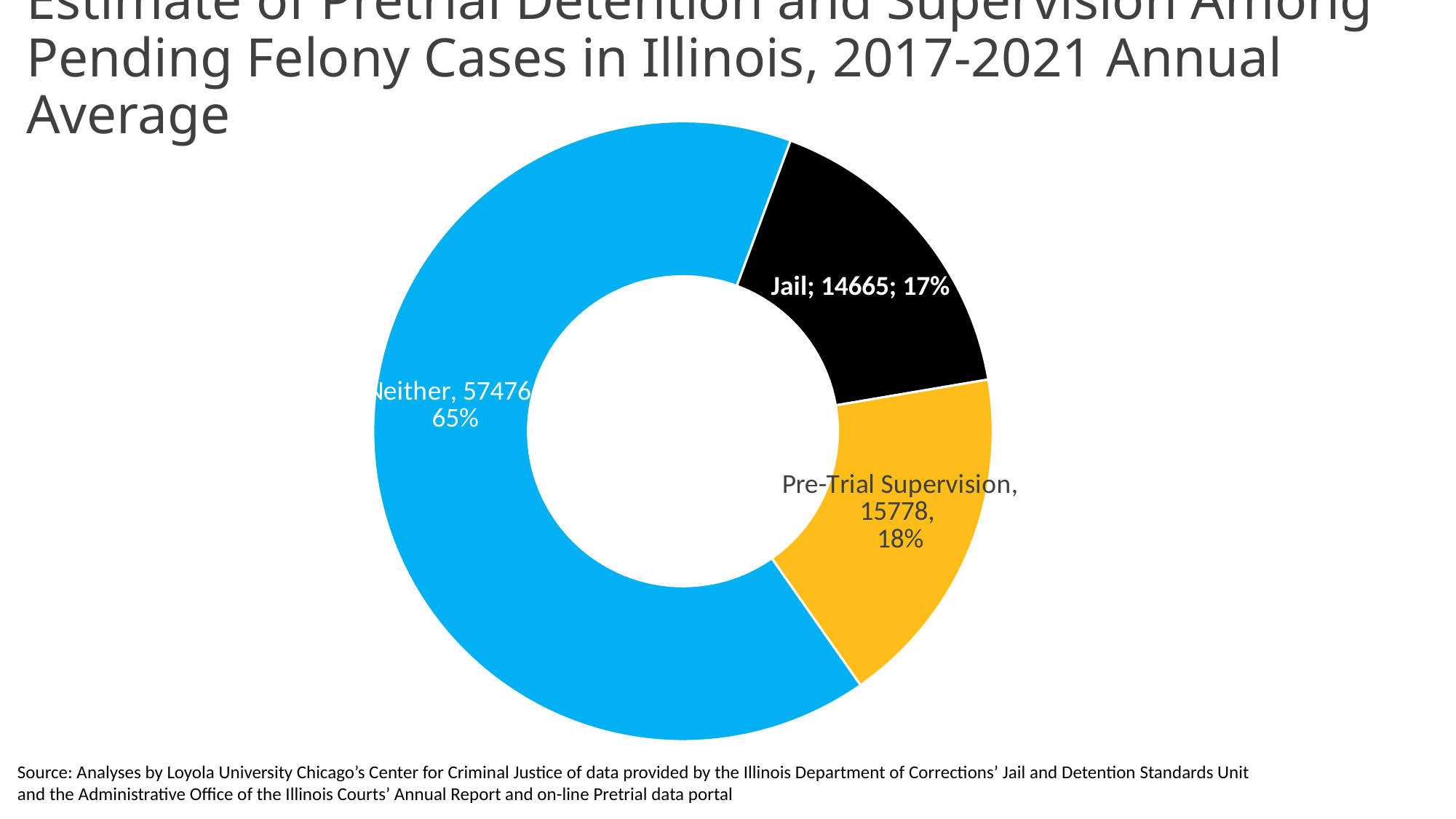
What kind of chart is shown on the slide? Doughnut (pie) chart Which category has the largest value? Neither What share of the chart does the Jail slice represent? 17% How many cases are in the Pre-Trial Supervision category? 15778 What colour is the Jail slice? Black What share of the chart does the Neither slice represent? 65% How many categories are shown in the chart? 3 How many cases are in the Neither category? 57476 What share of the chart does the Pre-Trial Supervision slice represent? 18% How many cases are in the Jail category? 14665 Which category has the smallest value? Jail What is the difference between the Pre-Trial Supervision and Jail values? 1113